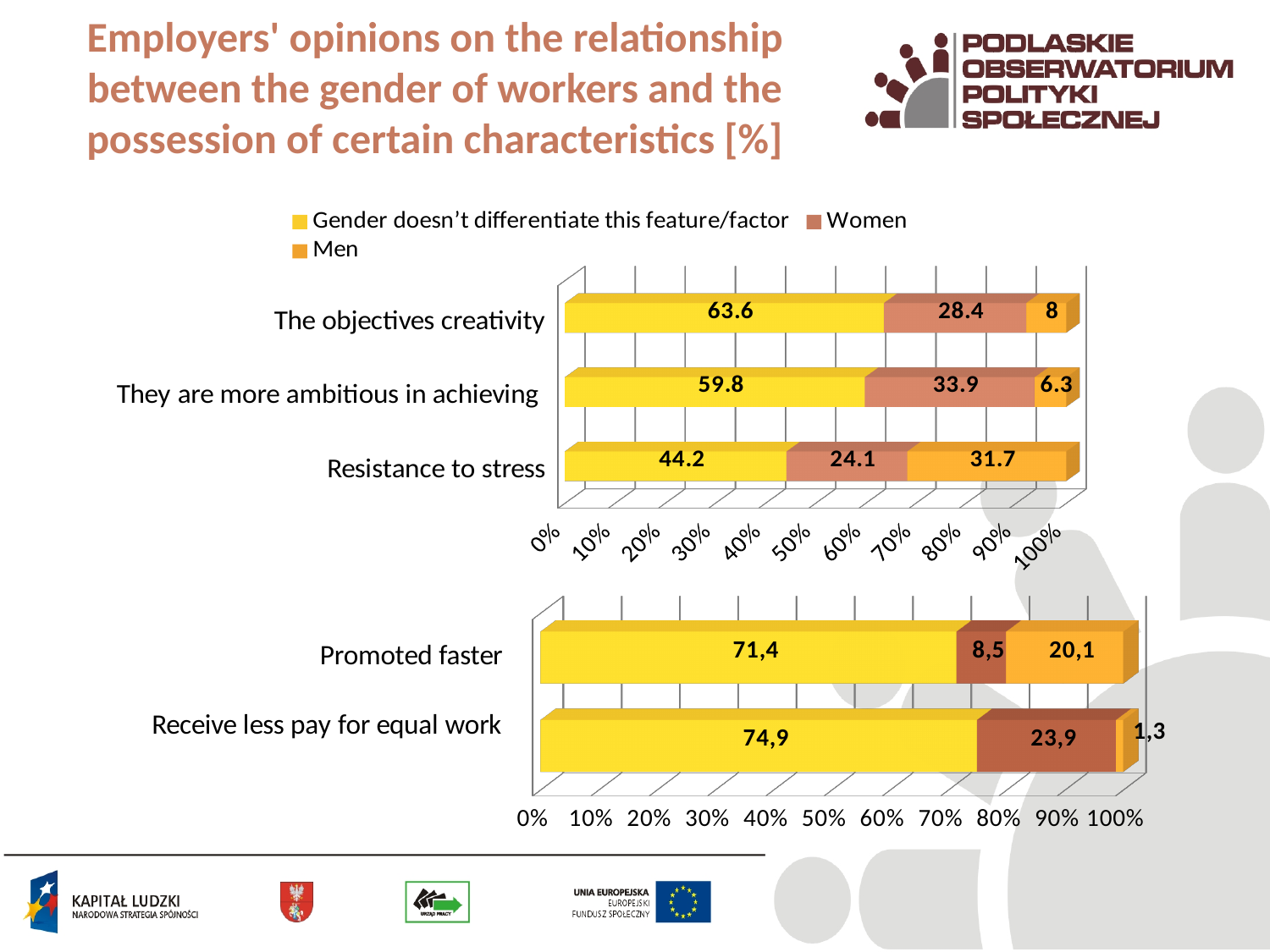
What kind of chart is the lower chart? Stacked bar chart In the upper chart, which category has the lowest 'Gender doesn't differentiate this feature/factor' value? Resistance to stress In the lower chart, which is larger: the 'Women' value for 'Promoted faster' or the 'Women' value for 'Receive less pay for equal work'? Receive less pay for equal work In the upper chart, which category has the highest 'Men' value? Resistance to stress In the lower chart, what is the 'Men' value for 'Promoted faster'? 20,1 In the upper chart, what is the 'Men' value for 'Resistance to stress'? 31.7 In the upper chart, what is the 'Women' value for 'They are more ambitious in achieving'? 33.9 How many series does the legend list? 3 In the upper chart, what is the difference between the 'Women' values for 'They are more ambitious in achieving' and 'The objectives creativity'? 5.5 In the upper chart, what is the value for 'Gender doesn't differentiate this feature/factor' for 'The objectives creativity'? 63.6 How many categories are shown in the upper chart? 3 In the lower chart, what is the 'Women' value for 'Receive less pay for equal work'? 23,9